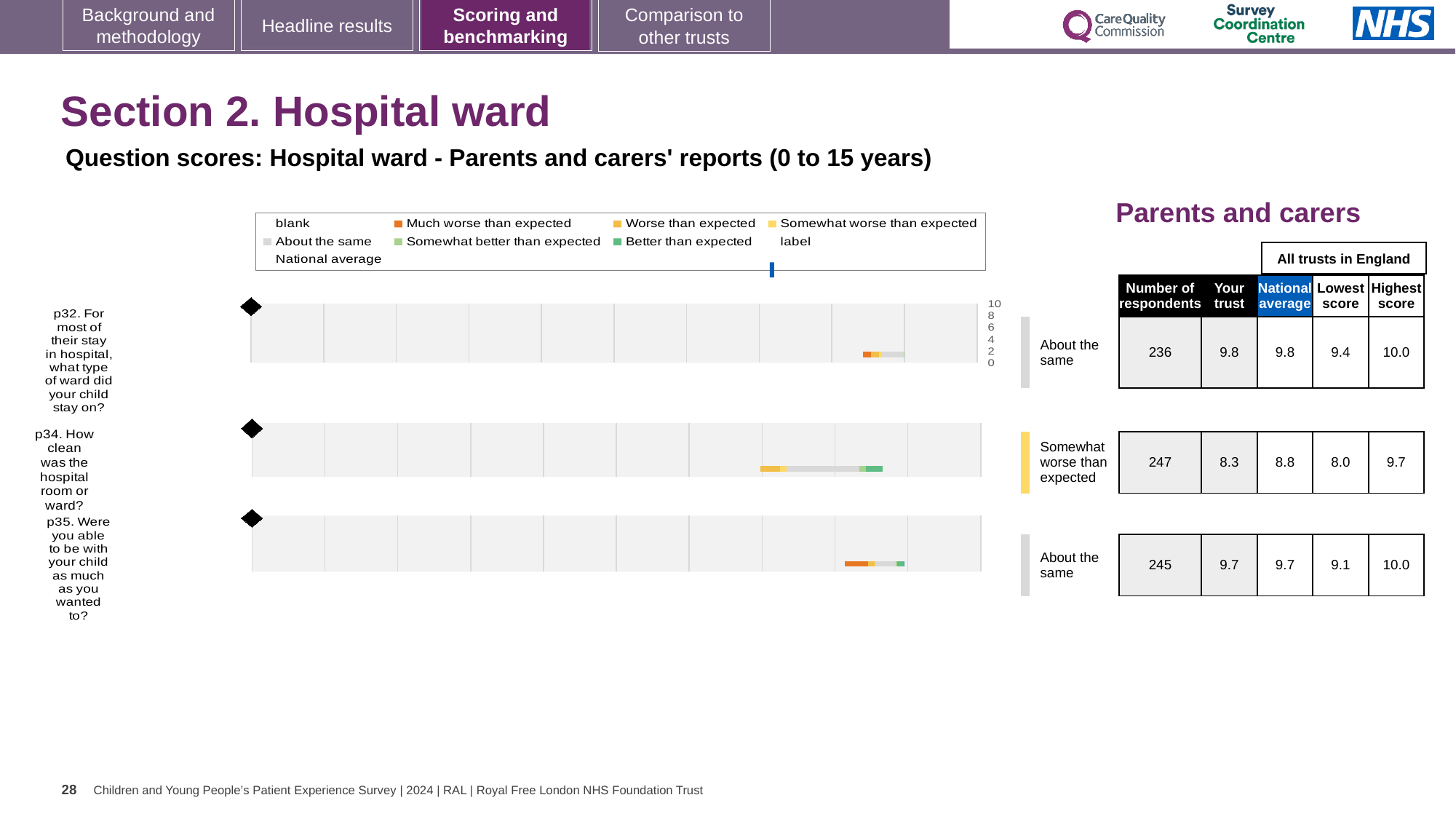
What is the 'Your trust' score for p34 (How clean was the hospital room or ward?)? 8.3 What kind of chart is used to show the question scores for p32, p34 and p35? bar chart What is the difference between the highest score and the lowest score across all trusts in England for p34? 1.7 What is the lowest score across all trusts in England for p35? 9.1 What is the difference between the 'Your trust' scores for p32 and p34? 1.5 What benchmark category is shown for p34 (How clean was the hospital room or ward?)? Somewhat worse than expected Which question has the lowest 'Your trust' score? p34 For p34, which is larger: the 'Your trust' score or the national average? National average Which question has the highest 'Your trust' score? p32 How many questions are plotted in the Hospital ward parents and carers' chart? 3 How many respondents answered p35 (Were you able to be with your child as much as you wanted to?)? 245 What is the national average score for p32 (For most of their stay in hospital, what type of ward did your child stay on?)? 9.8